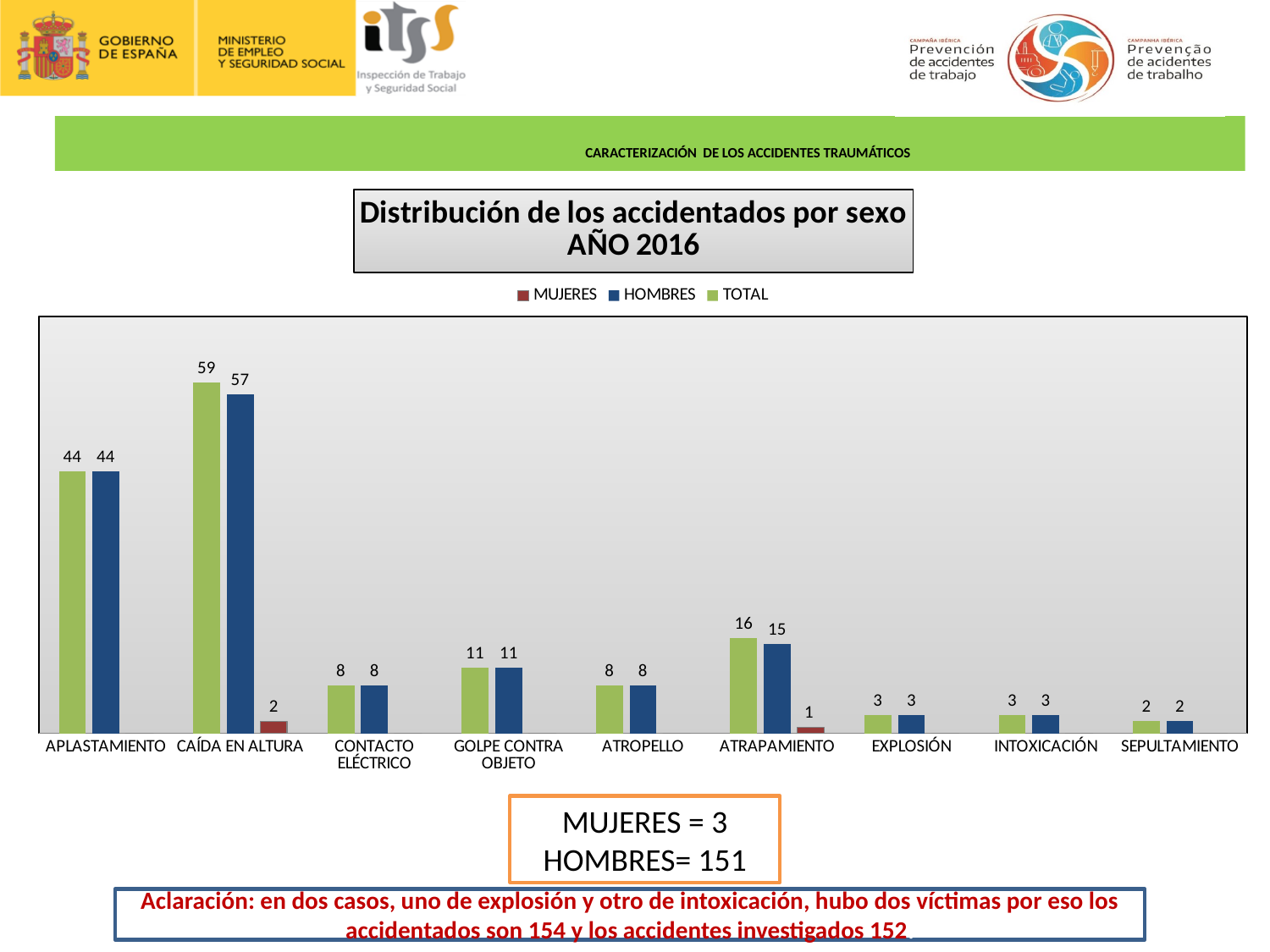
What is the difference between the TOTAL values for CAÍDA EN ALTURA and APLASTAMIENTO? 15 What is the title of the chart? Distribución de los accidentados por sexo AÑO 2016 How many categories are shown on the x axis? 9 Which is larger, the HOMBRES value for ATRAPAMIENTO or the HOMBRES value for GOLPE CONTRA OBJETO? ATRAPAMIENTO What kind of chart is shown? Bar chart How many series does the legend list? 3 What is the HOMBRES value for CAÍDA EN ALTURA? 57 What is the MUJERES value for ATRAPAMIENTO? 1 What is the TOTAL value for CAÍDA EN ALTURA? 59 Which category has the lowest TOTAL value? SEPULTAMIENTO Which category has the highest TOTAL value? CAÍDA EN ALTURA What is the TOTAL value for APLASTAMIENTO? 44